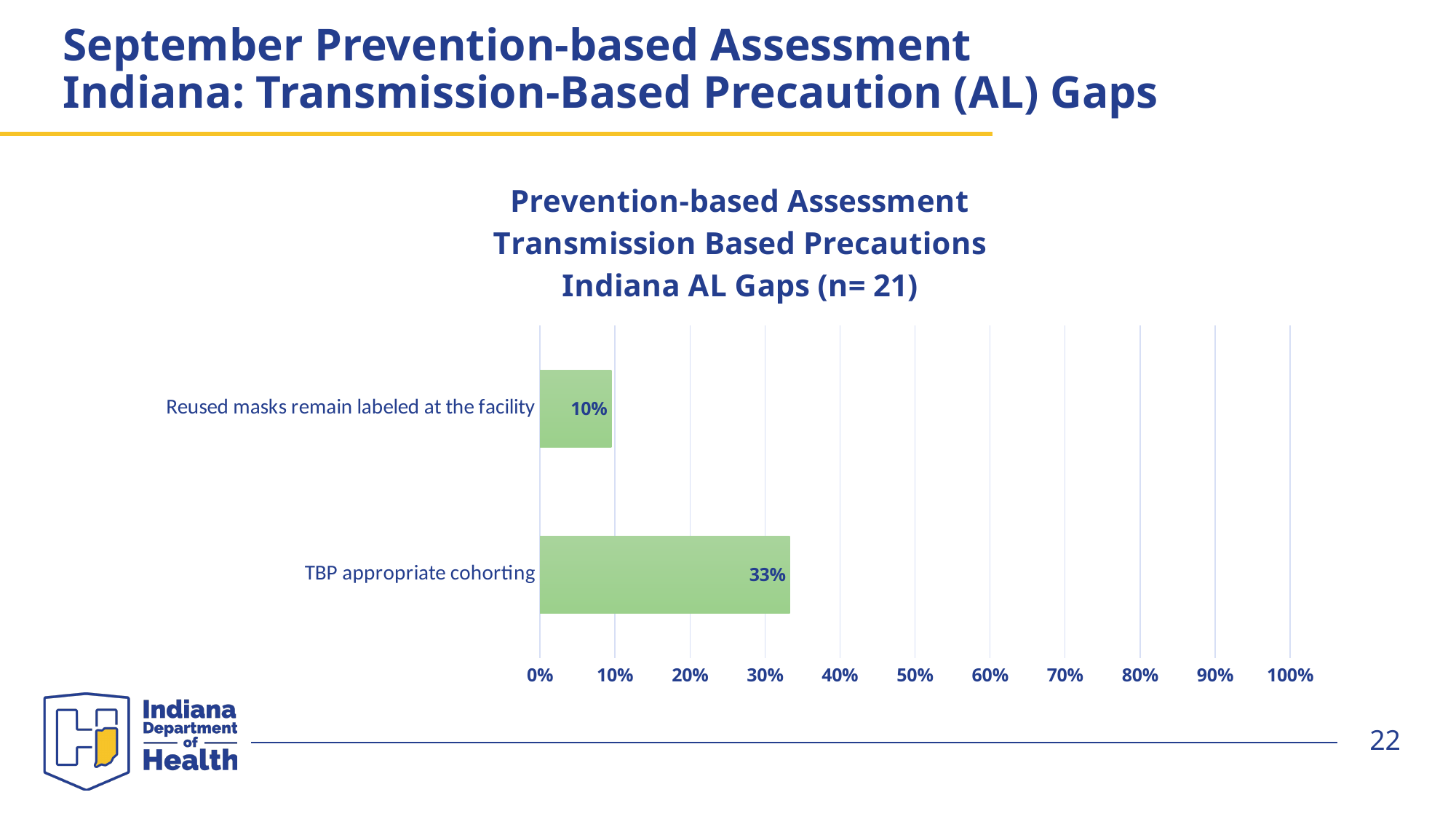
What is the value for 'Reused masks remain labeled at the facility'? 10% How many categories are shown in the chart? 2 What kind of chart is shown on the slide? bar chart Is the value for 'TBP appropriate cohorting' greater or less than 20%? greater What is the difference between the values for 'TBP appropriate cohorting' and 'Reused masks remain labeled at the facility'? 23% Which is larger: the value for 'TBP appropriate cohorting' or the value for 'Reused masks remain labeled at the facility'? TBP appropriate cohorting What is the sample size (n) given in the chart title? 21 Is the value for 'TBP appropriate cohorting' greater or less than 50%? less What is the value for 'TBP appropriate cohorting'? 33% What is the maximum value shown on the x axis? 100% Which category has the highest value? TBP appropriate cohorting Which category has the lowest value? Reused masks remain labeled at the facility